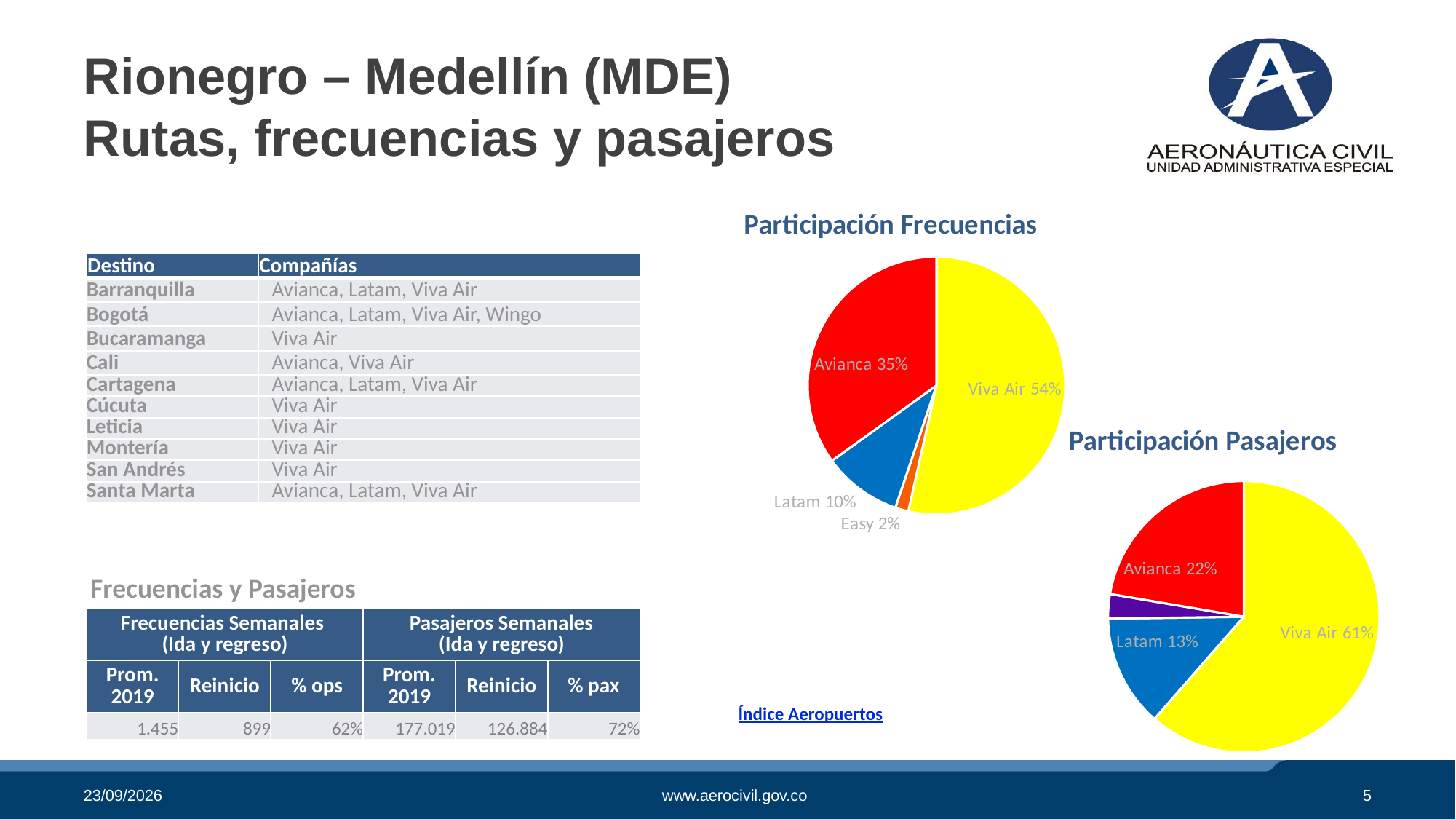
In the 'Participación Frecuencias' chart, which airline has the largest share? Viva Air What type of chart is 'Participación Pasajeros'? Pie chart In the 'Participación Frecuencias' chart, which airline has the smallest share? Easy In the 'Participación Frecuencias' chart, what share does Latam have? 10% In the 'Participación Pasajeros' chart, what share does Latam have? 13% In the 'Participación Frecuencias' chart, what share does Avianca have? 35% In the 'Participación Frecuencias' chart, what share does Viva Air have? 54% In the 'Participación Pasajeros' chart, what colour is the Viva Air slice? Yellow In the 'Participación Pasajeros' chart, which is larger, the Avianca share or the Latam share? Avianca In the 'Participación Frecuencias' chart, how many slices are labelled? 4 In the 'Participación Pasajeros' chart, what share does Viva Air have? 61% In the 'Participación Frecuencias' chart, what is the difference between the Viva Air and Avianca shares? 19%